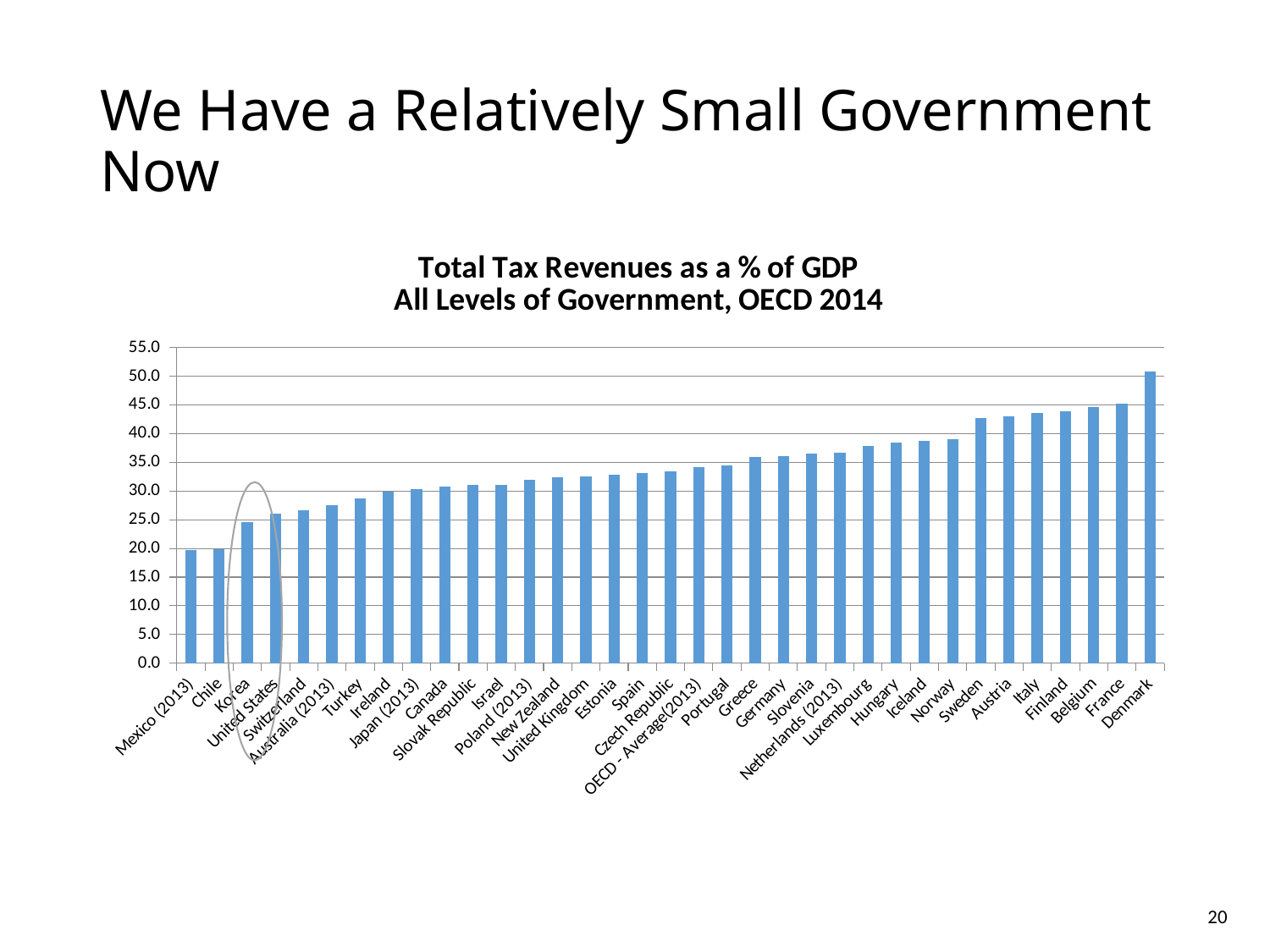
Do the values rise or fall moving from left to right along the x axis? rise Is the value for Hungary greater or less than 35.0? greater Which is larger, the value for the United States or the value for Denmark? Denmark Which country has the highest total tax revenue as a % of GDP? Denmark Is the value for Mexico (2013) greater or less than 25.0? less Is the value for Denmark greater or less than 45.0? greater What is the title of the chart? Total Tax Revenues as a % of GDP All Levels of Government, OECD 2014 Which country's bar is circled on the chart? United States What kind of chart is shown on the slide? bar chart How many bars (countries/averages) are plotted in the chart? 35